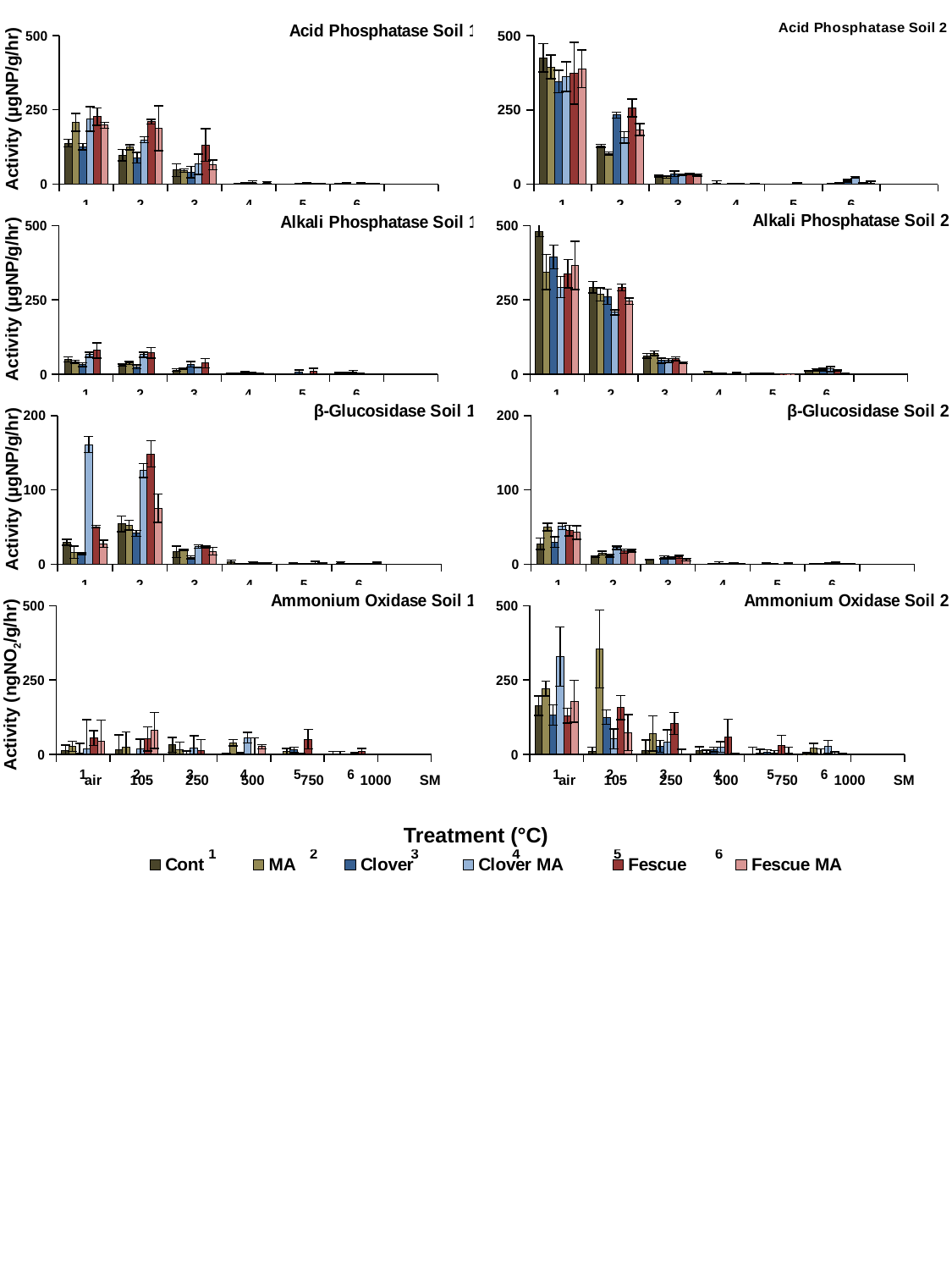
In the "Acid Phosphatase Soil 2" chart, do the values generally rise or fall from the air treatment to the 1000 treatment? fall What kind of chart is the "Acid Phosphatase Soil 1" chart? bar chart In the "β-Glucosidase Soil 1" chart, is the value for Clover MA at the air treatment greater or less than 100? greater In the "β-Glucosidase Soil 1" chart, which series has the highest value at the air treatment? Clover MA In the "Ammonium Oxidase Soil 2" chart, is the value for MA at the 105 treatment greater or less than 250? greater In the "β-Glucosidase Soil 1" chart, which is larger at the air treatment: Cont or Clover MA? Clover MA In the "β-Glucosidase Soil 2" chart, is the value for Clover MA at the air treatment greater or less than 100? less How many series does the shared legend at the bottom of the slide list? 6 What is the y-axis label of the "Ammonium Oxidase Soil 2" chart? Activity (ngNO2/g/hr) In the "Ammonium Oxidase Soil 1" chart, how many treatment categories are labelled on the x axis? 7